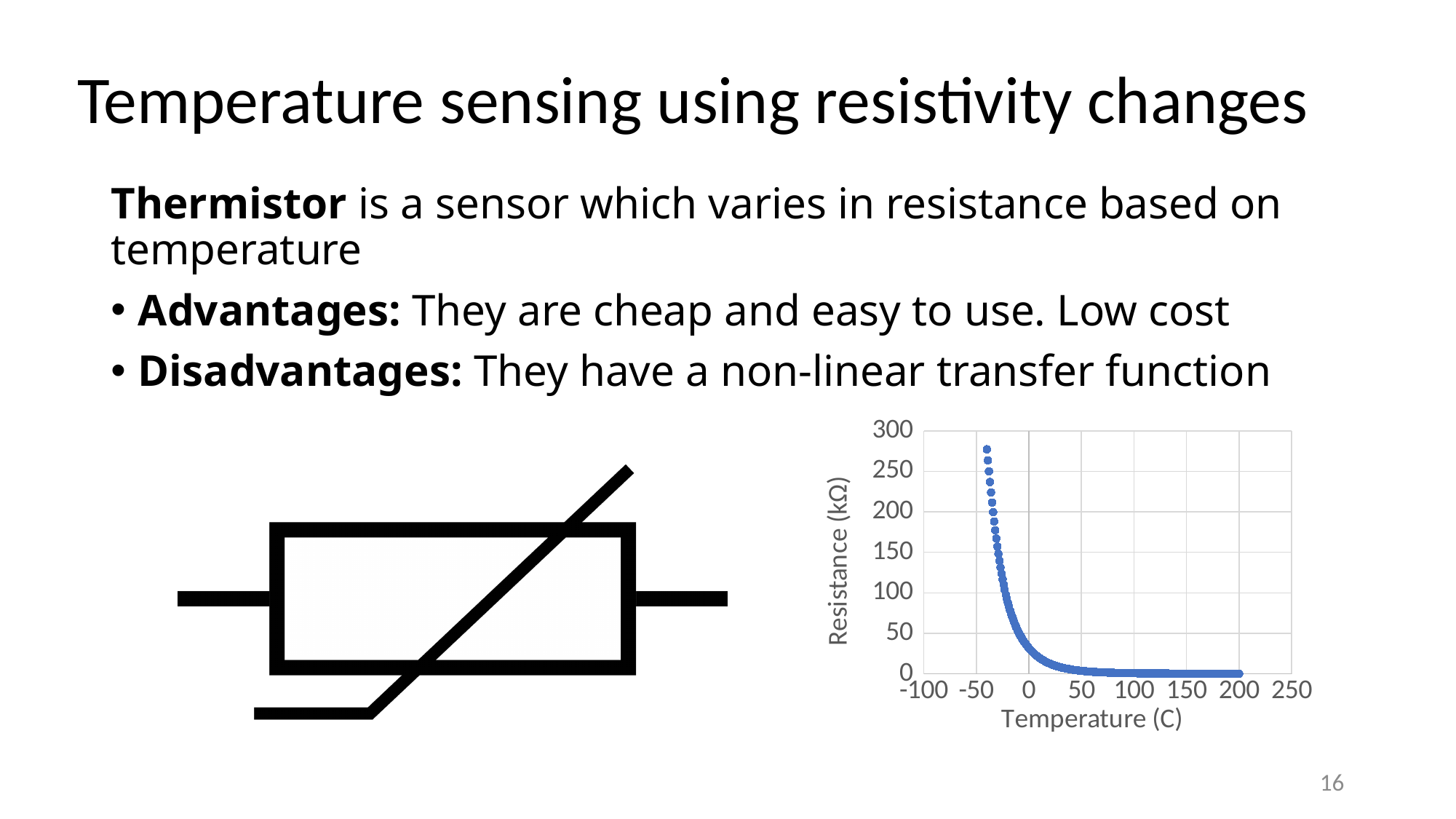
What kind of chart is shown on the slide? scatter chart Is the resistance at 200 C greater or less than 50 kΩ? less As temperature increases along the x axis, does the resistance rise or fall? fall What is the label of the vertical axis of the chart? Resistance (kΩ) Is the resistance at the lowest plotted temperature (about -40 C) greater or less than 250 kΩ? greater Is the resistance at a temperature of 100 C greater or less than 50 kΩ? less What is the label of the horizontal axis of the chart? Temperature (C) Which has the higher resistance: the point at -40 C or the point at 50 C? -40 C